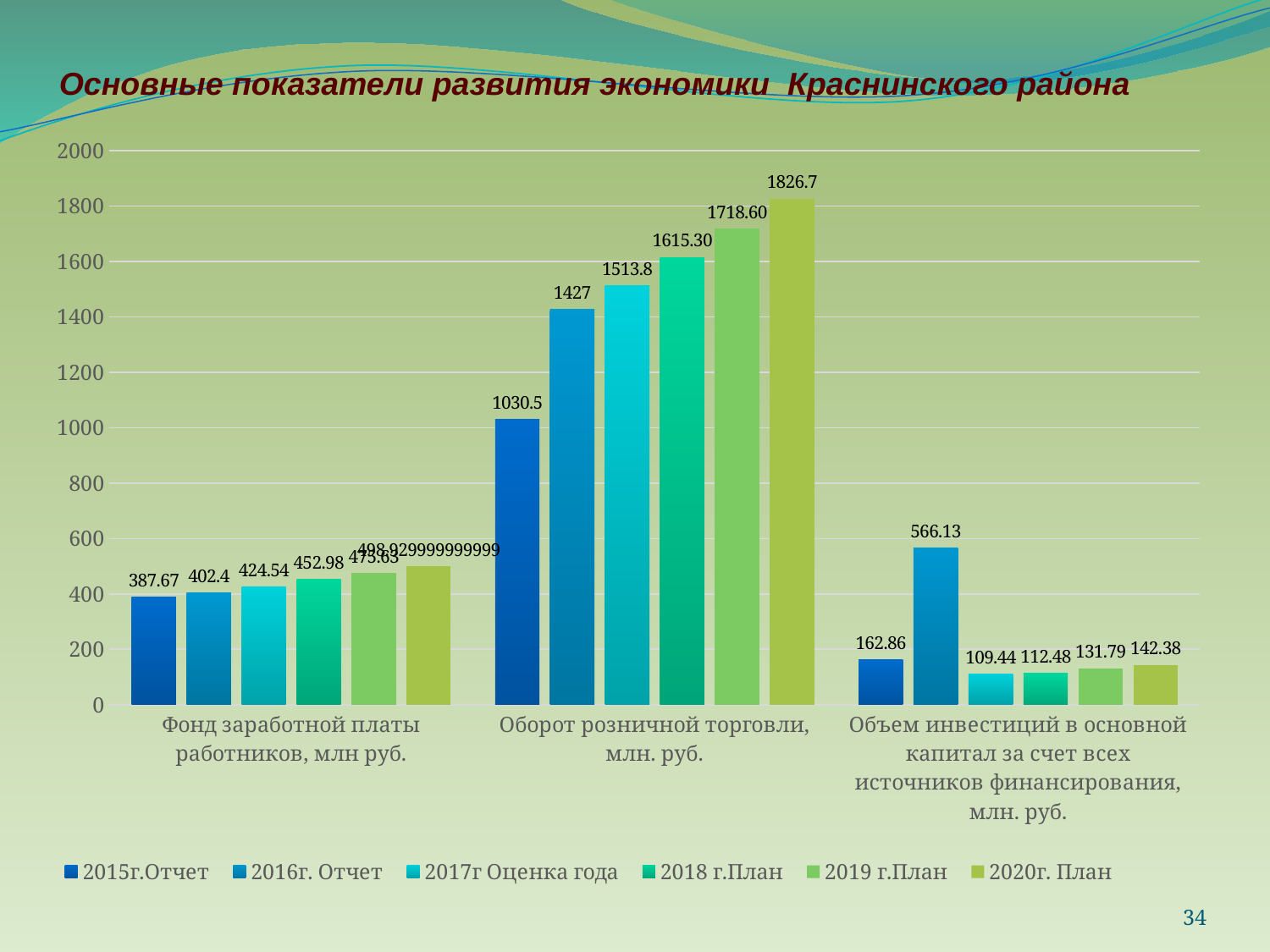
What is the value for 2015г.Отчет in the category Фонд заработной платы работников, млн руб.? 387.67 How many categories are shown on the x axis? 3 What type of chart is shown on the slide? bar chart Which is larger in the category Объем инвестиций в основной капитал: the 2015г.Отчет value or the 2020г. План value? 2015г.Отчет What is the title of the chart? Основные показатели развития экономики Краснинского района What is the value for 2016г. Отчет in the category Объем инвестиций в основной капитал за счет всех источников финансирования, млн. руб.? 566.13 Which series has the lowest value in the category Объем инвестиций в основной капитал за счет всех источников финансирования, млн. руб.? 2017г Оценка года How many series does the legend list? 6 What is the value for 2020г. План in the category Оборот розничной торговли, млн. руб.? 1826.7 What is the difference between the 2016г. Отчет and 2015г.Отчет values in the category Оборот розничной торговли, млн. руб.? 396.5 Which series has the highest value in the category Оборот розничной торговли, млн. руб.? 2020г. План Do the values for Оборот розничной торговли, млн. руб. rise or fall from 2015г.Отчет to 2020г. План? rise